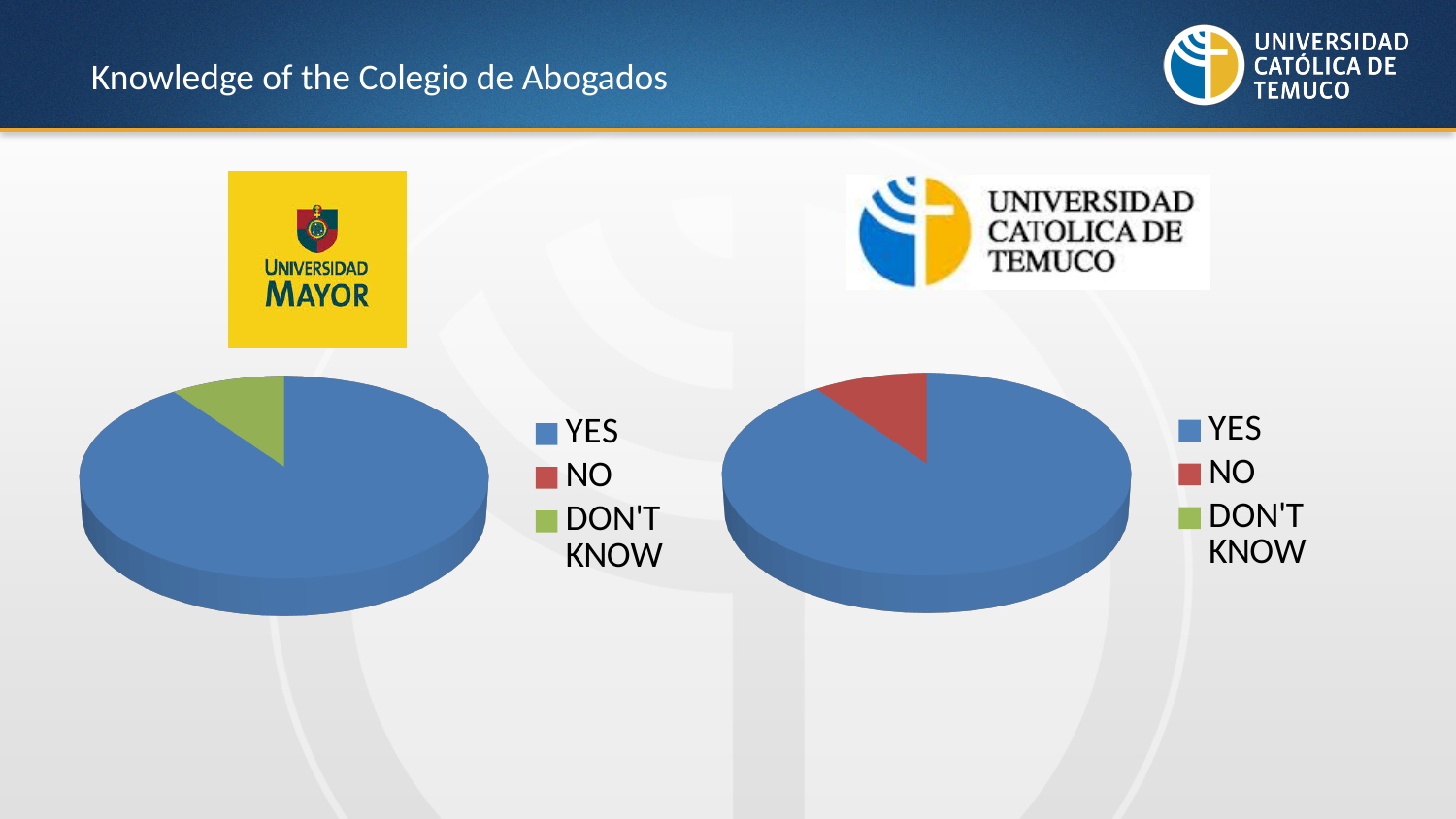
In the left chart (Universidad Mayor), which category other than YES has a visible slice? DON'T KNOW What is the title of the slide containing the two pie charts? Knowledge of the Colegio de Abogados What kind of chart is the right chart (Universidad Católica de Temuco)? pie chart How many entries does the legend of the left chart (Universidad Mayor) list? 3 What kind of chart is the left chart (Universidad Mayor)? pie chart What colour represents YES in both pie charts? blue In the right chart (Universidad Católica de Temuco), which category has the largest slice? YES In the left chart (Universidad Mayor), which category has the largest slice? YES How many entries does the legend of the right chart (Universidad Católica de Temuco) list? 3 In the left chart (Universidad Mayor), which is larger, YES or DON'T KNOW? YES In the right chart (Universidad Católica de Temuco), which is larger, NO or YES? YES